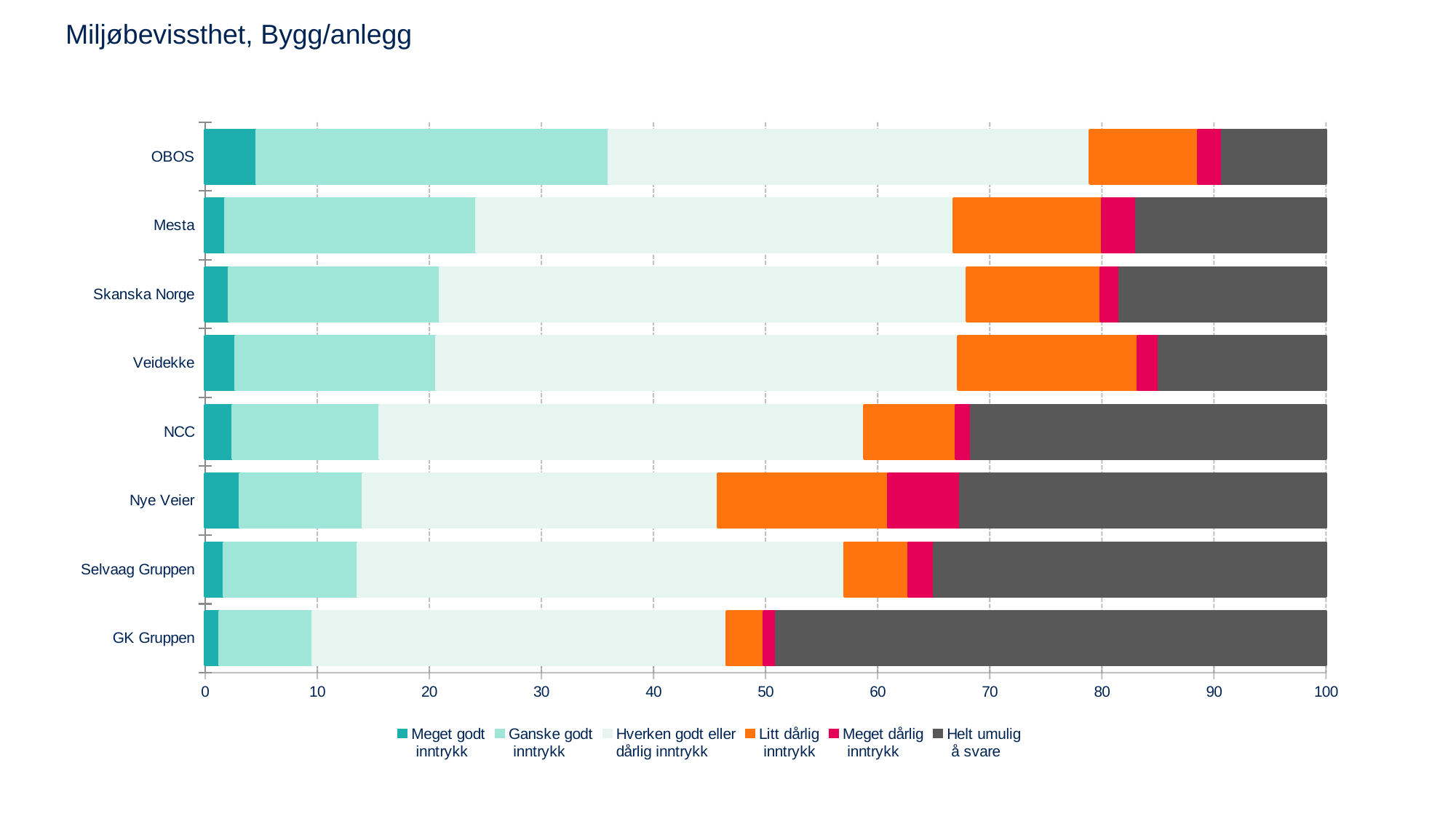
How many series does the legend list? 6 What is the title of the chart? Miljøbevissthet, Bygg/anlegg Which company has the largest 'Meget dårlig inntrykk' segment? Nye Veier Which legend entry is shown in dark grey? Helt umulig å svare Is the 'Helt umulig å svare' value for GK Gruppen greater or less than 40? greater Is the 'Meget godt inntrykk' value for OBOS greater or less than 10? less Which company has the largest 'Helt umulig å svare' segment? GK Gruppen What kind of chart is shown on the slide? Stacked bar chart How many companies are listed on the vertical axis of the chart? 8 Which company has the largest 'Meget godt inntrykk' segment? OBOS Which company has the larger 'Ganske godt inntrykk' segment, OBOS or Mesta? OBOS Which company has the smallest 'Ganske godt inntrykk' segment? GK Gruppen